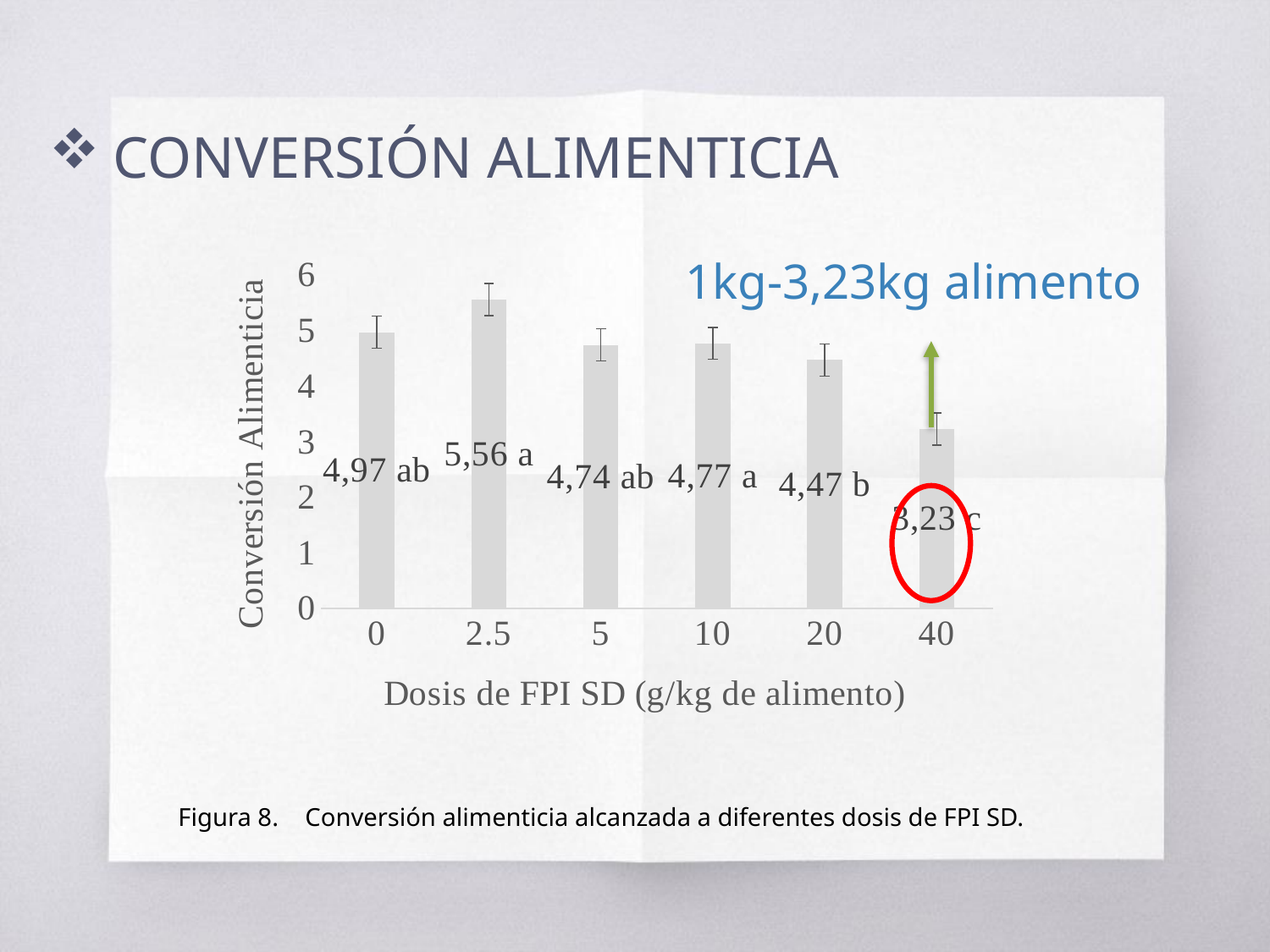
Is the value for the 40 g/kg dose greater or less than 4? less What is the title of the x axis? Dosis de FPI SD (g/kg de alimento) Which dose has a larger feed conversion value, 0 or 20? 0 What is the feed conversion value for the 40 g/kg dose? 3,23 What is the difference between the feed conversion values at doses 2.5 and 40? 2,33 What is the feed conversion value for the 2.5 g/kg dose? 5,56 What is the feed conversion value for the 0 g/kg dose? 4,97 What is the feed conversion value for the 20 g/kg dose? 4,47 What kind of chart is shown on the slide? bar chart Which dose has the highest feed conversion value? 2.5 How many dose categories are shown on the x axis? 6 Which dose has the lowest feed conversion value? 40